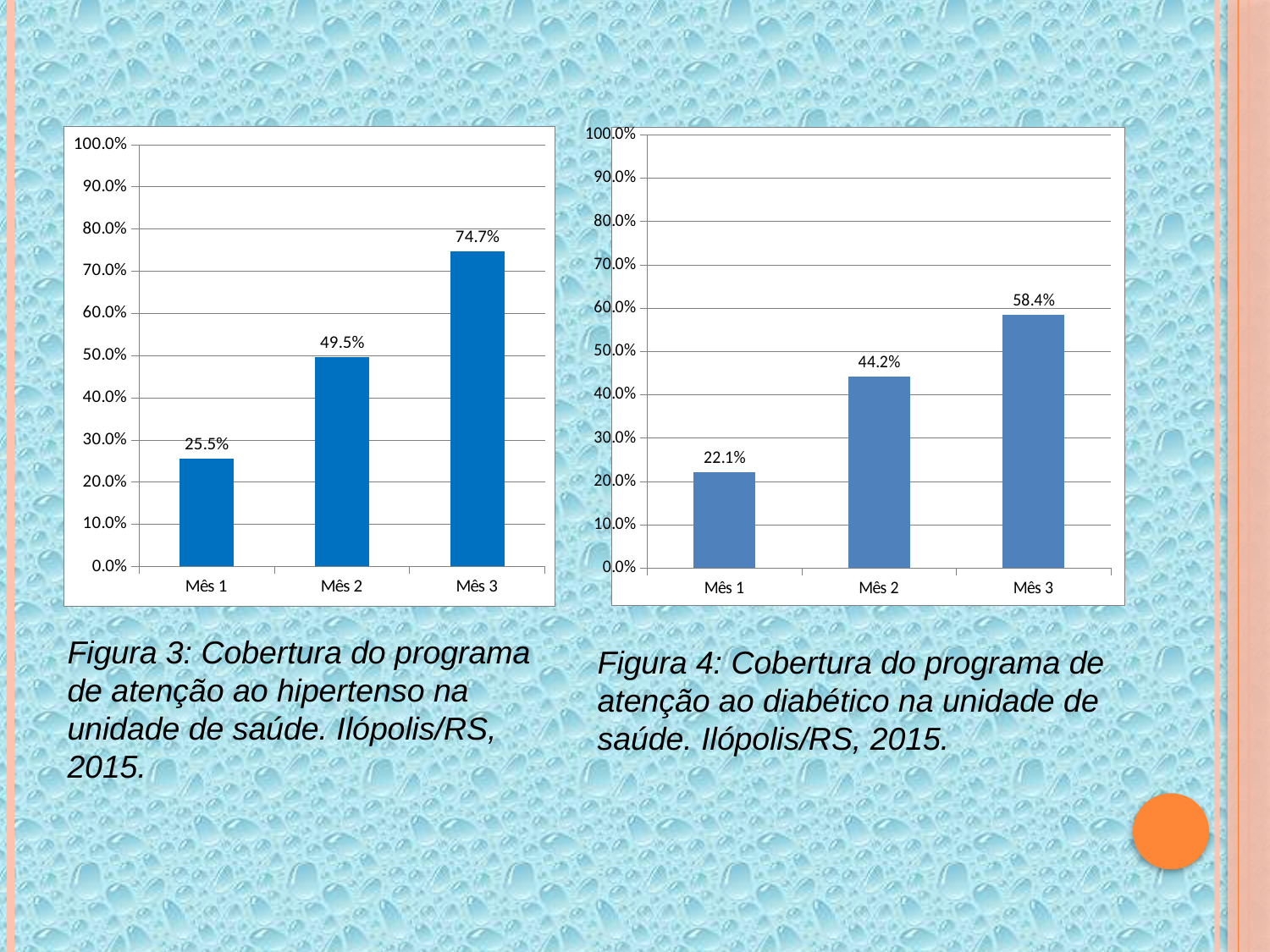
In the left chart (Figura 3, hipertenso), which month has the highest value? Mês 3 In the right chart (Figura 4, diabético), what is the difference between Mês 2 and Mês 1? 22.1% In the right chart (Figura 4, diabético), do the values rise or fall from Mês 1 to Mês 3? Rise In the left chart (Figura 3, hipertenso), what is the value for Mês 2? 49.5% In the right chart (Figura 4, diabético), which month has the lowest value? Mês 1 In the left chart (Figura 3, hipertenso), what is the difference between Mês 3 and Mês 1? 49.2% What is the caption of the left chart? Figura 3: Cobertura do programa de atenção ao hipertenso na unidade de saúde. Ilópolis/RS, 2015. How many categories are shown on the x axis of the left chart (Figura 3)? 3 In the right chart (Figura 4, diabético), what is the value for Mês 3? 58.4% Which is larger: Mês 3 in the left chart (Figura 3) or Mês 3 in the right chart (Figura 4)? Mês 3 in the left chart (Figura 3) What kind of chart is the right chart (Figura 4)? Bar chart In the right chart (Figura 4, diabético), is the value for Mês 2 greater or less than 40.0%? greater